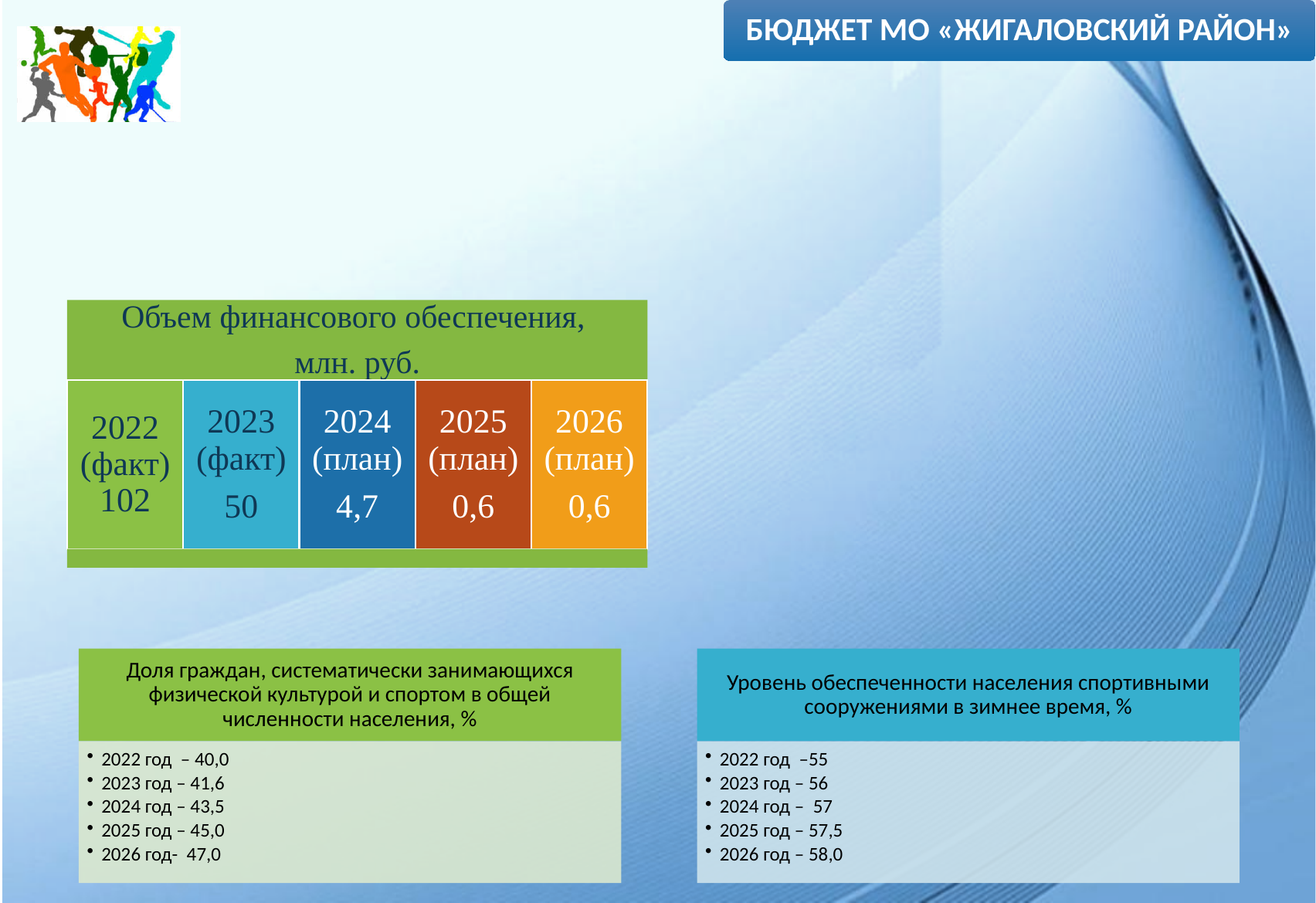
In the 'Уровень обеспеченности населения спортивными сооружениями в зимнее время, %' box, what is the value for 2025? 57,5 In the 'Объем финансового обеспечения, млн. руб.' graphic, which year has the highest value? 2022 (факт) In the 'Объем финансового обеспечения, млн. руб.' graphic, what colour is the 2025 (план) block? brown (dark orange-red) In the 'Объем финансового обеспечения, млн. руб.' graphic, do the values rise or fall from 2022 to 2026? fall In the 'Доля граждан, систематически занимающихся физической культурой и спортом' box, what is the value for 2024? 43,5 In the 'Объем финансового обеспечения, млн. руб.' graphic, how many years are shown? 5 In the 'Объем финансового обеспечения, млн. руб.' graphic, what is the planned value for 2026? 0,6 In the 'Объем финансового обеспечения, млн. руб.' graphic, what is the planned value for 2024? 4,7 In the 'Объем финансового обеспечения, млн. руб.' graphic, what is the value for 2022 (факт)? 102 In the 'Объем финансового обеспечения, млн. руб.' graphic, what is the difference between the 2022 and 2023 values? 52 In the 'Объем финансового обеспечения, млн. руб.' graphic, which is larger: the 2023 value or the 2024 value? 2023 In the 'Объем финансового обеспечения, млн. руб.' graphic, what is the value for 2023 (факт)? 50